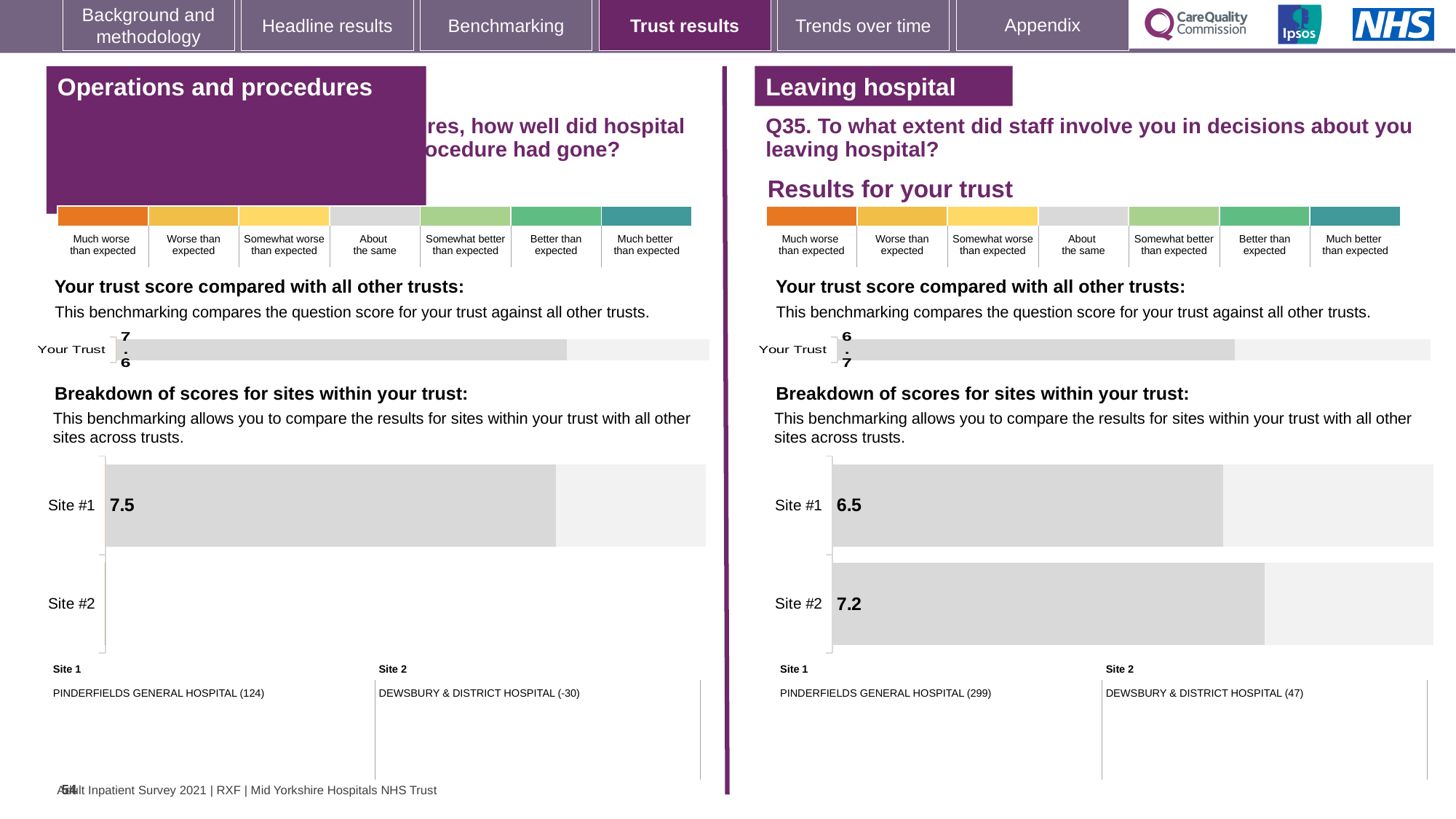
On the 'Leaving hospital' site breakdown chart on the right, what is the score for Site #1? 6.5 What type of chart is the 'Leaving hospital' site breakdown chart on the right? bar chart On the 'Leaving hospital' trust score chart on the right, what is the score shown for Your Trust? 6.7 On the 'Operations and procedures' trust score chart on the left, what is the score shown for Your Trust? 7.6 How many sites are listed on the 'Operations and procedures' site breakdown chart on the left? 2 On the 'Leaving hospital' site breakdown chart on the right, is the score for Site #1 larger or smaller than the score for Site #2? smaller On the 'Operations and procedures' site breakdown chart on the left, which site has no bar or score shown? Site #2 On the 'Leaving hospital' site breakdown chart on the right, which site has the lower score? Site #1 On the 'Leaving hospital' site breakdown chart on the right, what is the score for Site #2? 7.2 On the 'Operations and procedures' site breakdown chart on the left, what is the score for Site #1? 7.5 On the 'Leaving hospital' site breakdown chart on the right, which site has the higher score? Site #2 On the 'Leaving hospital' site breakdown chart on the right, what is the difference between the Site #2 and Site #1 scores? 0.7